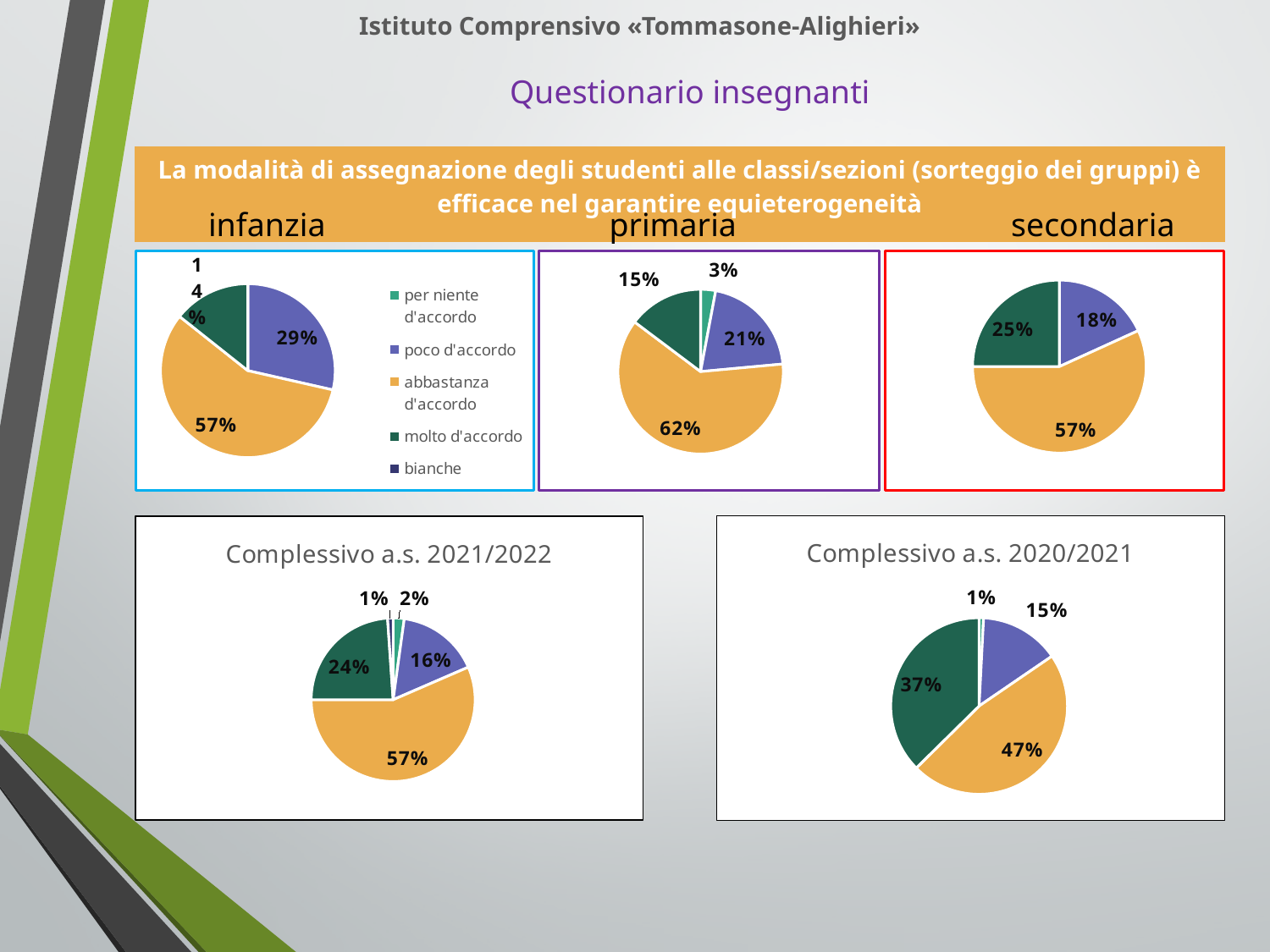
In the Complessivo a.s. 2021/2022 chart, what share is labelled for the molto d'accordo slice? 24% In the infanzia chart, what share is labelled for the poco d'accordo slice? 29% How many entries does the legend next to the infanzia chart list? 5 In the primaria chart, which slice is the smallest? per niente d'accordo (3%) In the secondaria chart, what share is labelled for the molto d'accordo slice? 25% In the primaria chart, which slice is the largest? abbastanza d'accordo (62%) What kind of charts are shown on the slide? Pie charts In the primaria chart, what share is labelled for the molto d'accordo slice? 15% In the infanzia chart, what share is labelled for the abbastanza d'accordo slice? 57% In the secondaria chart, what is the difference between the abbastanza d'accordo share and the poco d'accordo share? 39 percentage points Which is larger: the molto d'accordo share in the Complessivo a.s. 2020/2021 chart or in the Complessivo a.s. 2021/2022 chart? Complessivo a.s. 2020/2021 (37%) In the Complessivo a.s. 2020/2021 chart, what share is labelled for the abbastanza d'accordo slice? 47%